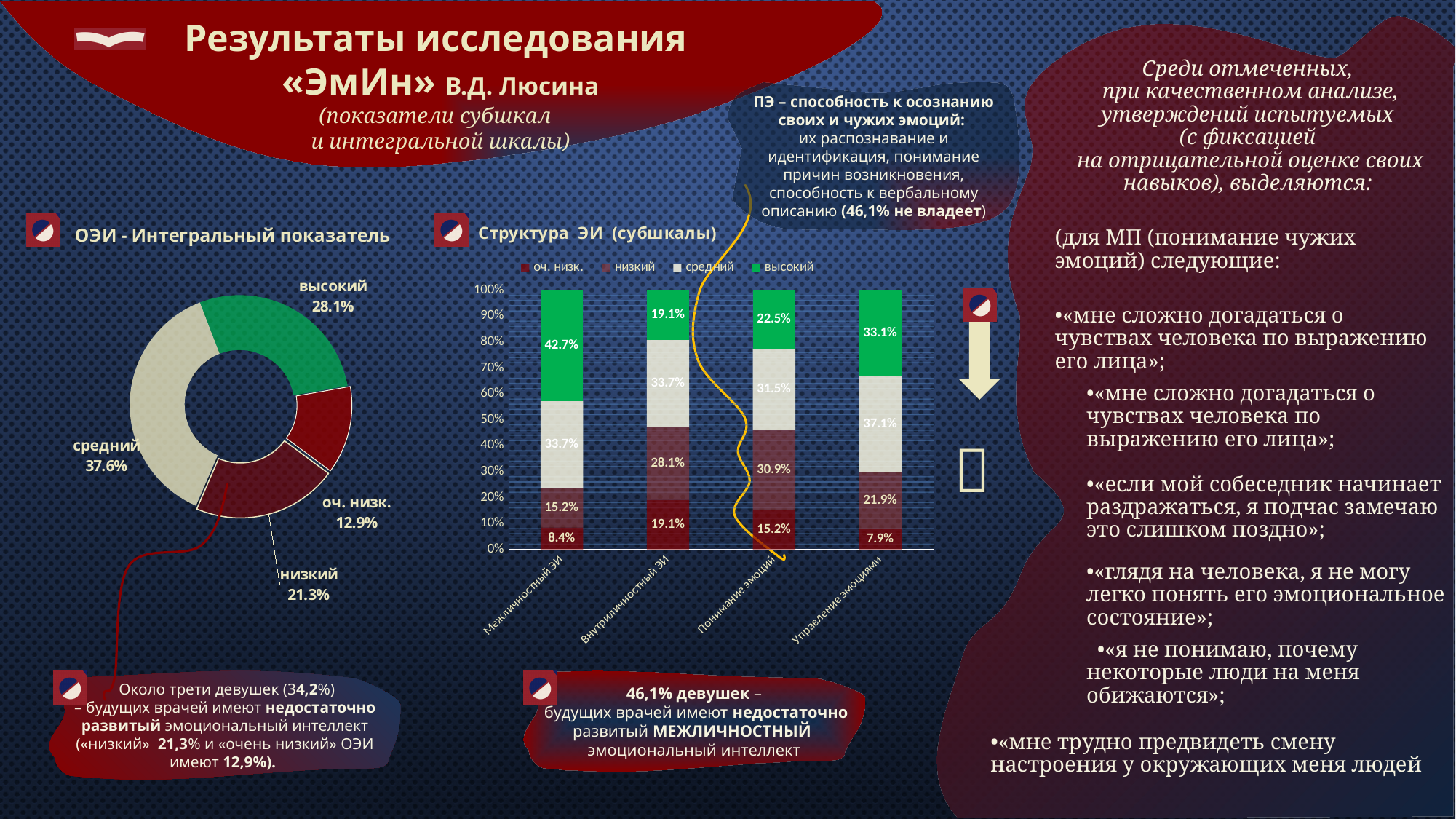
In the chart 'Структура ЭИ (субшкалы)', what is the 'оч. низк.' value for 'Управление эмоциями'? 7.9% In the chart 'Структура ЭИ (субшкалы)', which category has the lowest 'оч. низк.' value? Управление эмоциями In the chart 'ОЭИ - Интегральный показатель', what share is labelled 'высокий'? 28.1% In the chart 'ОЭИ - Интегральный показатель', what is the difference between the 'средний' and 'низкий' shares? 16.3% In the chart 'Структура ЭИ (субшкалы)', is the 'низкий' value larger for 'Понимание эмоций' or for 'Межличностный ЭИ'? Понимание эмоций In the chart 'Структура ЭИ (субшкалы)', what is the 'высокий' value for 'Межличностный ЭИ'? 42.7% In the chart 'ОЭИ - Интегральный показатель', which category has the largest share? средний How many categories are shown on the x axis of the chart 'Структура ЭИ (субшкалы)'? 4 In the chart 'Структура ЭИ (субшкалы)', which category has the highest 'высокий' value? Межличностный ЭИ What type of chart is 'ОЭИ - Интегральный показатель'? Doughnut chart How many series does the legend of the chart 'Структура ЭИ (субшкалы)' list? 4 In the chart 'ОЭИ - Интегральный показатель', which category has the smallest share? оч. низк.